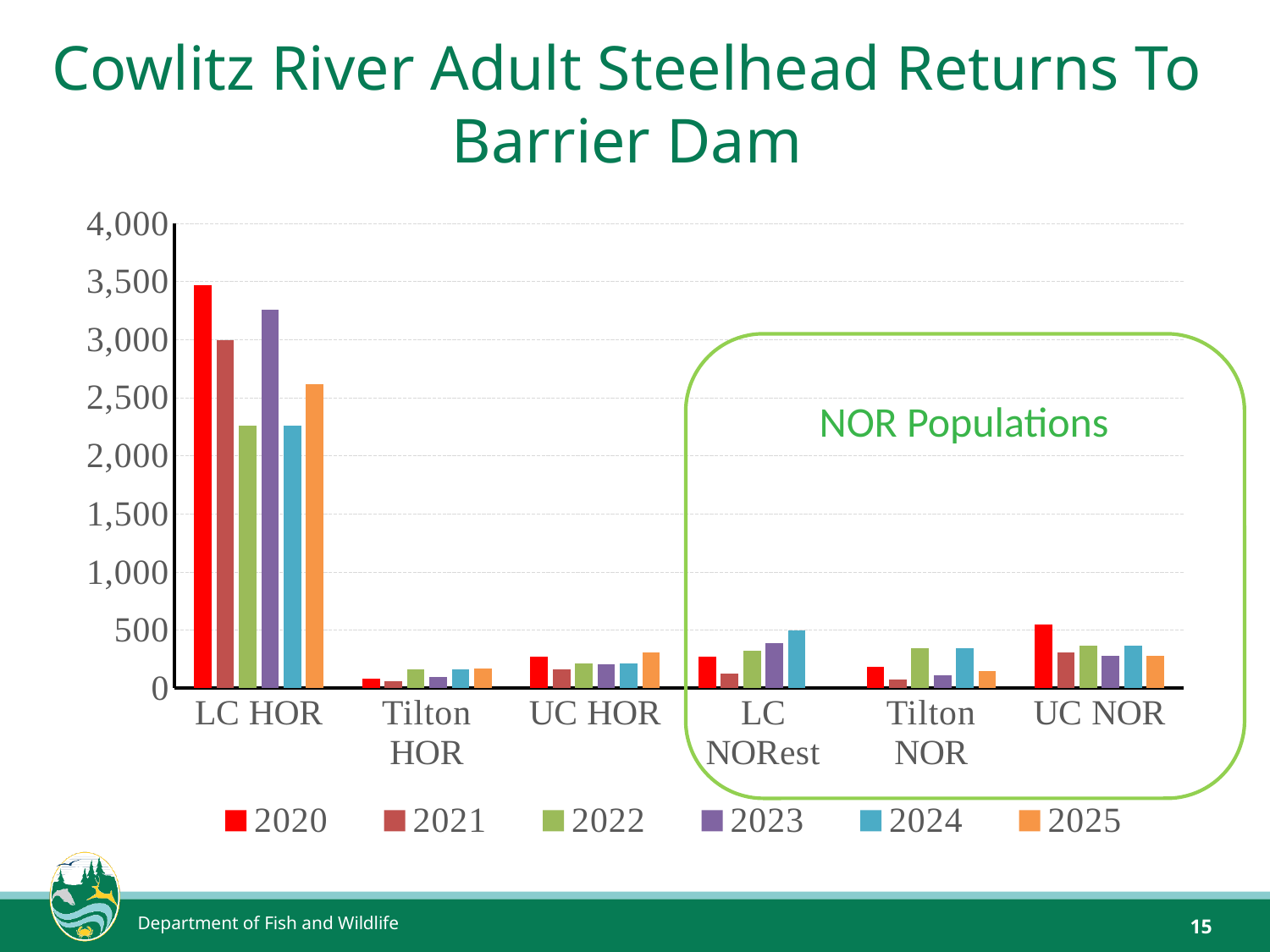
How many series does the legend list? 6 What is the title of the chart? Cowlitz River Adult Steelhead Returns To Barrier Dam Is the value for LC HOR in 2020 greater or less than 3,000? greater Is the value for LC HOR in 2022 greater or less than 2,500? less How many categories are shown along the x axis? 6 Within the LC HOR category, which year has the highest value? 2020 Which is larger for LC HOR: the 2020 value or the 2023 value? 2020 Within the LC NORest category, which year has the highest value? 2024 From 2021 to 2024, do the LC NORest values rise or fall? rise What kind of chart is shown on the slide? Bar chart Is the value for UC NOR in 2020 greater or less than 500? greater Which category has the highest bars overall? LC HOR